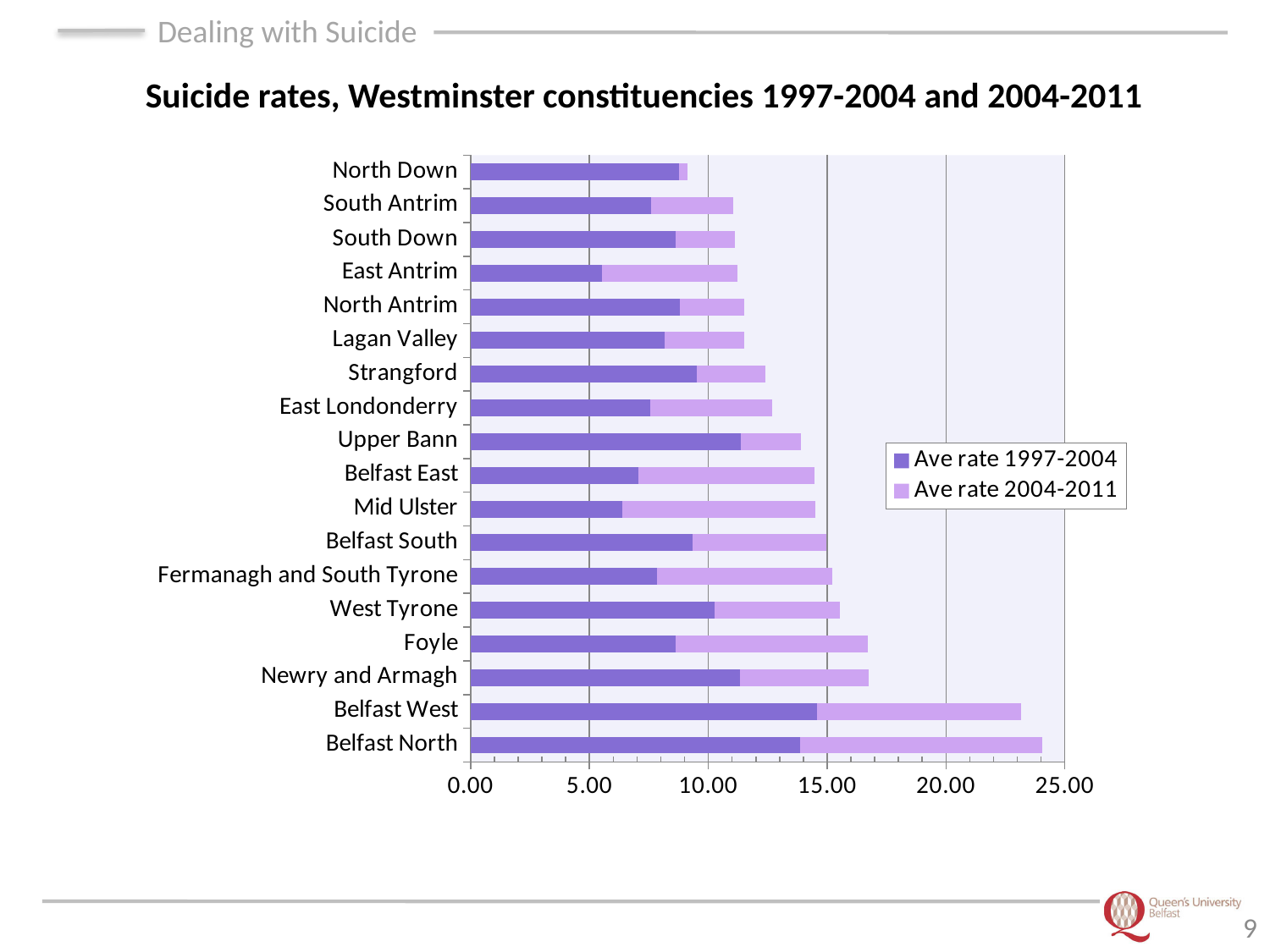
Which constituency has the lowest Ave rate 1997-2004 segment? East Antrim Is the Ave rate 1997-2004 value for East Antrim greater or less than 10.00? less What kind of chart is shown on the slide? Stacked bar chart Which constituency has the lowest combined (stacked) bar? North Down How many constituencies are plotted on the chart? 18 What are the two series named in the legend? Ave rate 1997-2004 and Ave rate 2004-2011 Is the total stacked value for North Down greater or less than 10.00? less Which constituency has the highest Ave rate 1997-2004 segment? Belfast West Is the total stacked value for Belfast North greater or less than 20.00? greater Which constituency has the highest combined (stacked) bar? Belfast North How many series does the legend list? 2 Which has the larger Ave rate 1997-2004 segment, Upper Bann or Belfast East? Upper Bann